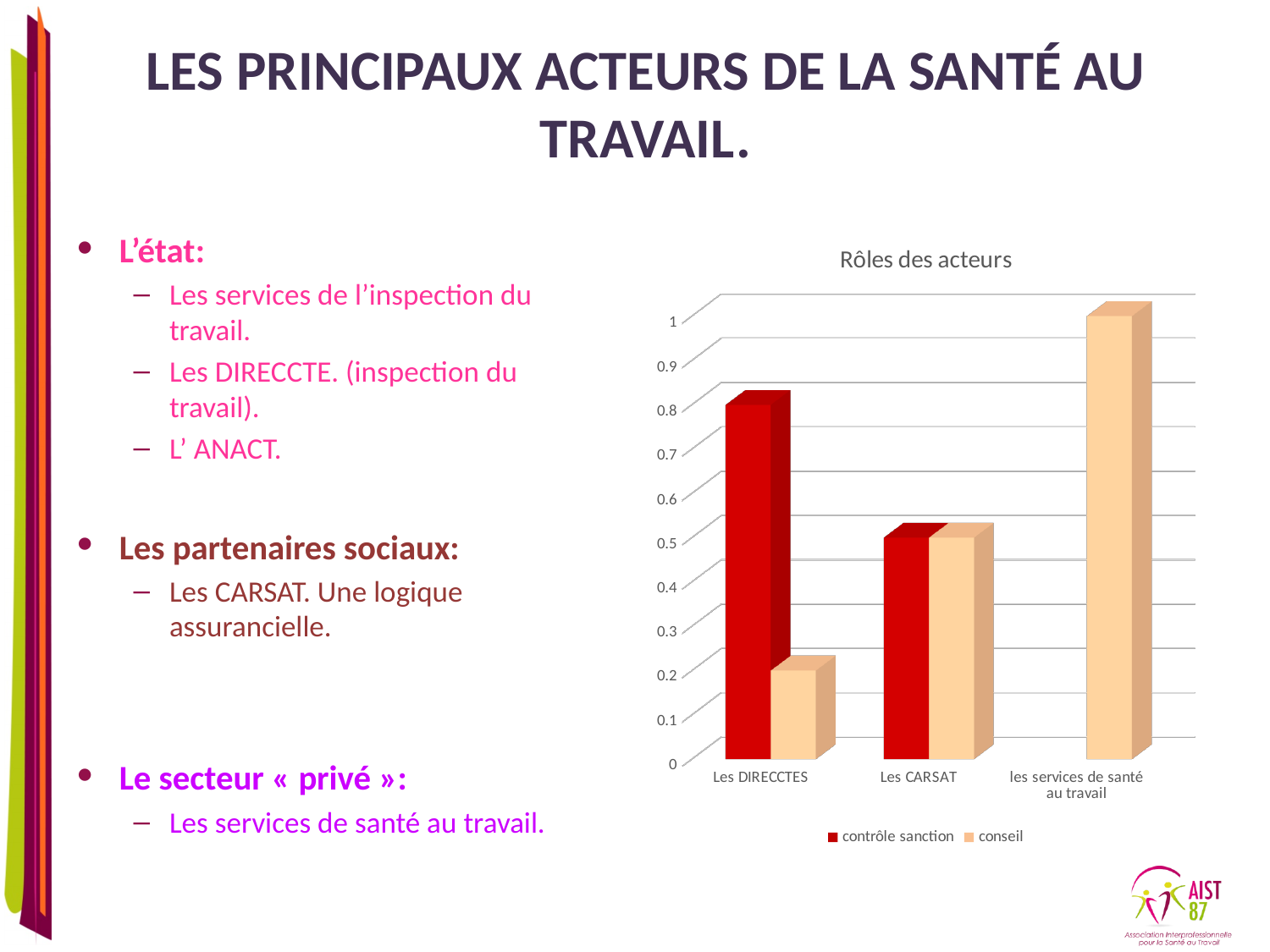
Is the 'contrôle sanction' value for Les DIRECCTES greater or less than 0.5? greater Is the 'conseil' value for Les DIRECCTES greater or less than 0.5? less Which category has the highest value for the 'conseil' series? les services de santé au travail What kind of chart is shown on the slide? bar chart What is the title of the chart on the slide? Rôles des acteurs How many categories are shown on the x axis of the chart? 3 For Les DIRECCTES, which series has the larger value, 'contrôle sanction' or 'conseil'? contrôle sanction Which series is shown in red in the chart? contrôle sanction How many series does the chart legend list? 2 Which category has the highest value for the 'contrôle sanction' series? Les DIRECCTES Which category has the lowest value for the 'conseil' series? Les DIRECCTES What is the 'conseil' value for les services de santé au travail? 1